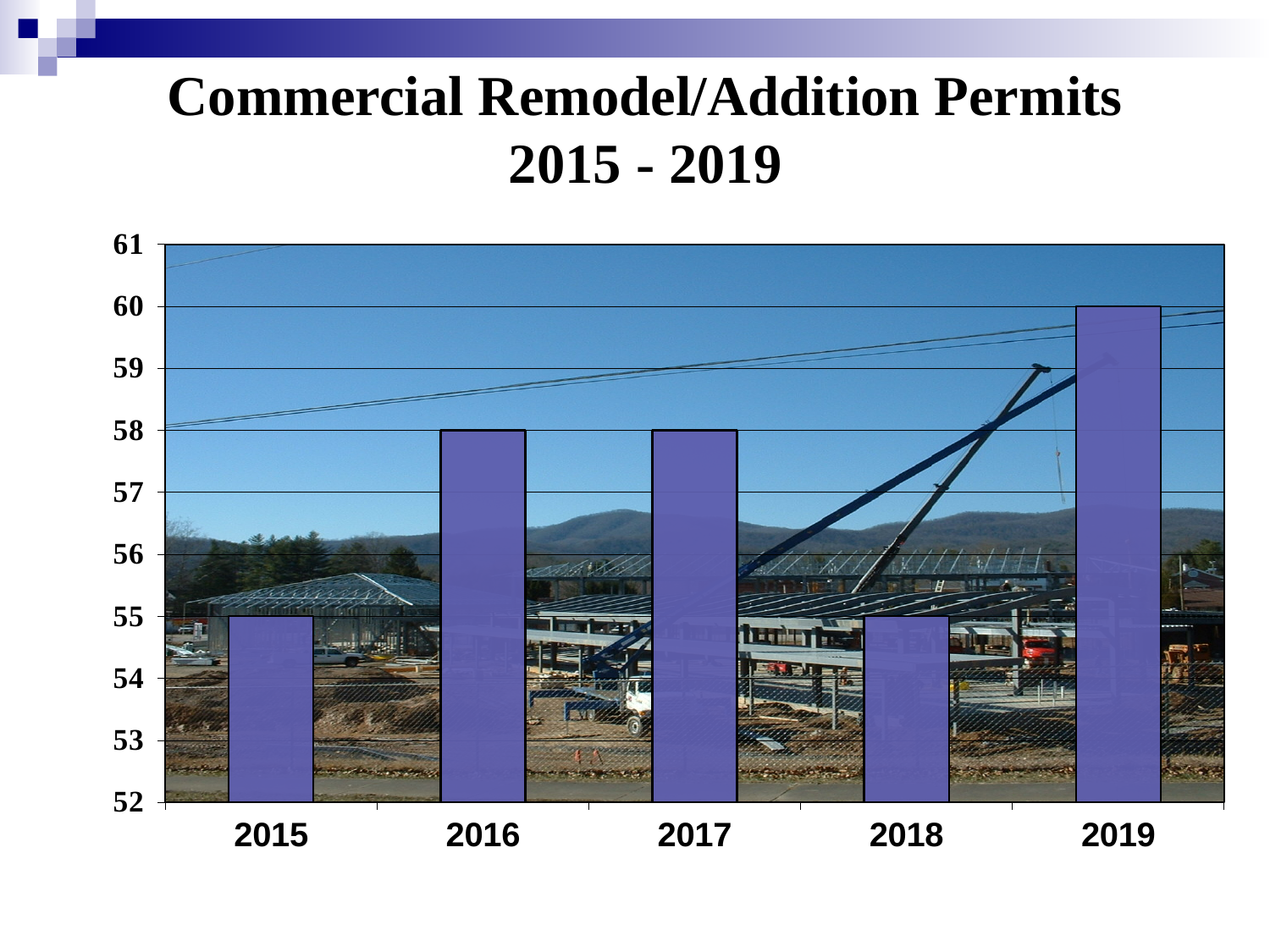
How many years are shown on the x axis? 5 What is the value for 2015? 55 What is the difference between the values for 2019 and 2018? 5 What is the value for 2016? 58 What is the value for 2019? 60 Do the values for 2016 and 2017 differ, or are they equal? equal What is the title of the chart? Commercial Remodel/Addition Permits 2015 - 2019 Which year has the highest value? 2019 What kind of chart is shown on the slide? bar chart Is the value for 2019 greater or less than 59? greater What is the difference between the values for 2016 and 2015? 3 Which is larger, the value for 2017 or the value for 2018? 2017